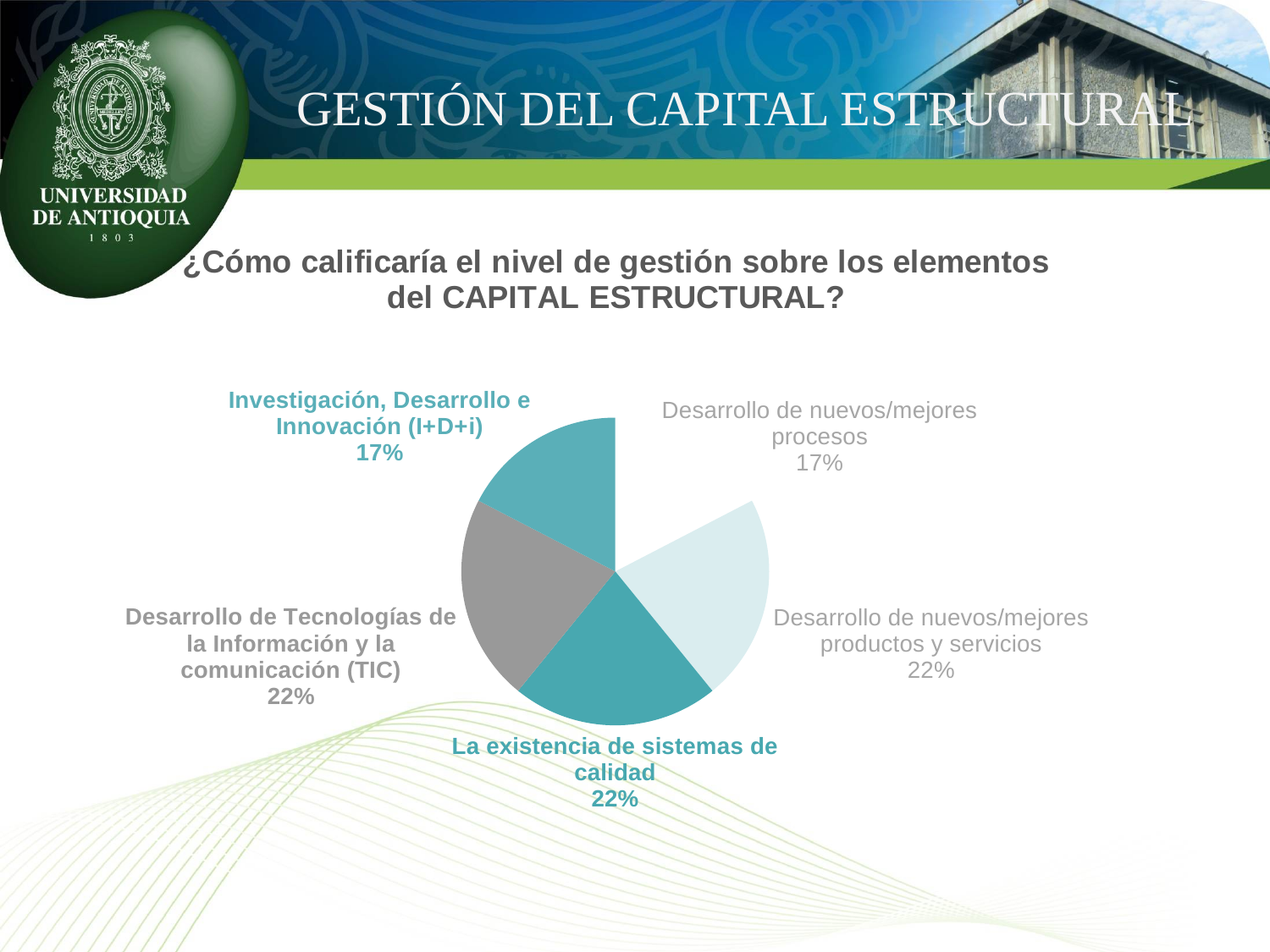
What percentage is shown for "Desarrollo de nuevos/mejores procesos"? 17% Which is larger: the share for "La existencia de sistemas de calidad" or the share for "Desarrollo de nuevos/mejores procesos"? La existencia de sistemas de calidad What share of the pie is labelled "Investigación, Desarrollo e Innovación (I+D+i)"? 17% What kind of chart is shown on the slide? pie chart What is the combined share of the two slices labelled 17%? 34% What percentage is shown for "Desarrollo de nuevos/mejores productos y servicios"? 22% How many slices of the pie chart are labelled 22%? 3 What is the difference in percentage points between "Desarrollo de Tecnologías de la Información y la comunicación (TIC)" and "Investigación, Desarrollo e Innovación (I+D+i)"? 5 percentage points What question does the pie chart answer, according to the text above it? ¿Cómo calificaría el nivel de gestión sobre los elementos del CAPITAL ESTRUCTURAL? What percentage is shown for "Desarrollo de Tecnologías de la Información y la comunicación (TIC)"? 22% What percentage is shown for "La existencia de sistemas de calidad"? 22% How many slices does the pie chart have? 5